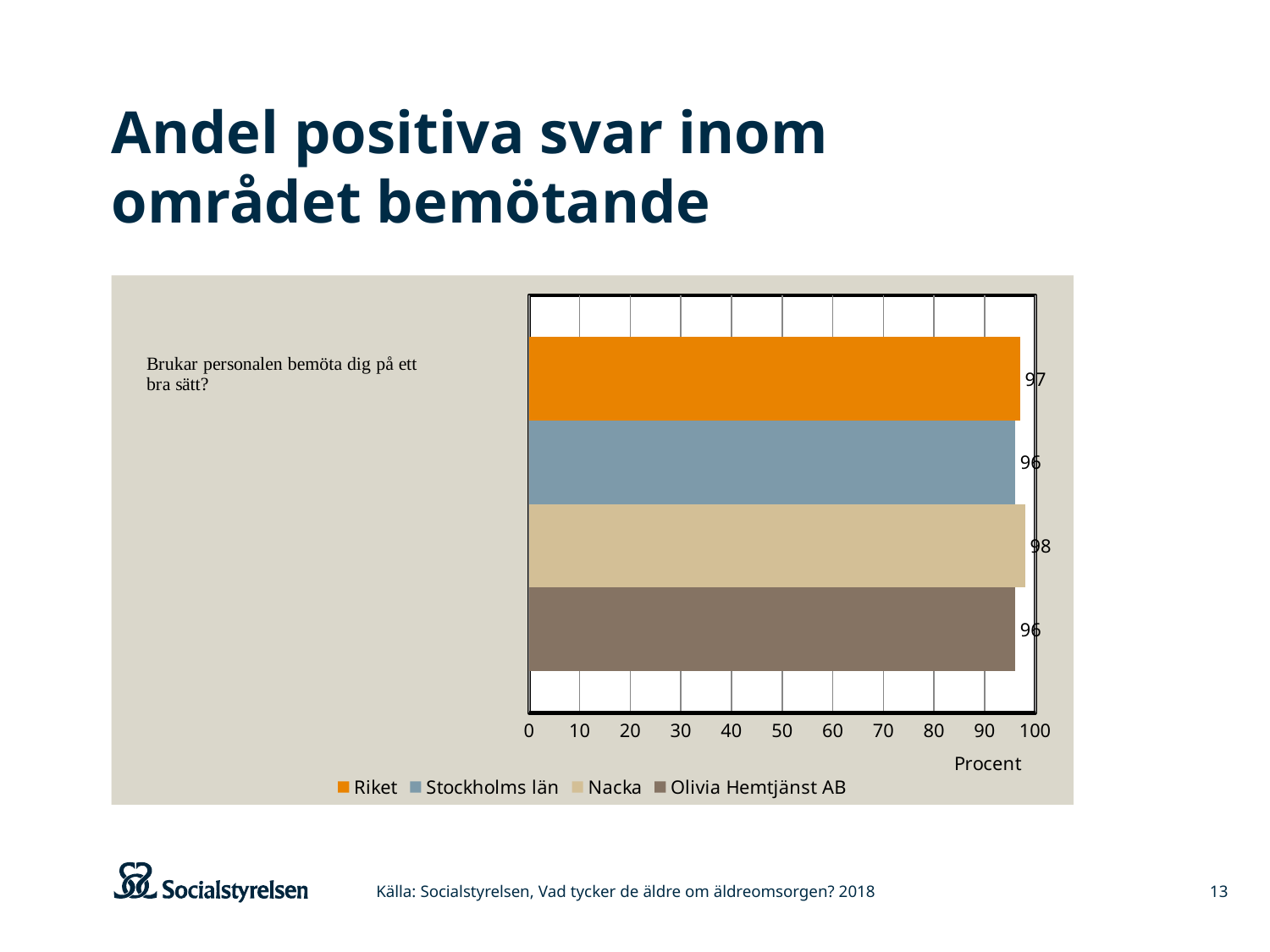
What kind of chart is shown on the slide? bar chart What is the value for Stockholms län? 96 How many series does the legend list? 4 What is the value for Nacka? 98 What is the value for Riket? 97 Which is larger, the value for Riket or the value for Stockholms län? Riket What is the value for Olivia Hemtjänst AB? 96 What is the difference between the values for Nacka and Olivia Hemtjänst AB? 2 What is the label on the horizontal axis of the chart? Procent Which series has the highest value? Nacka Is the value for Olivia Hemtjänst AB greater or less than 90? greater What is the difference between the values for Nacka and Riket? 1